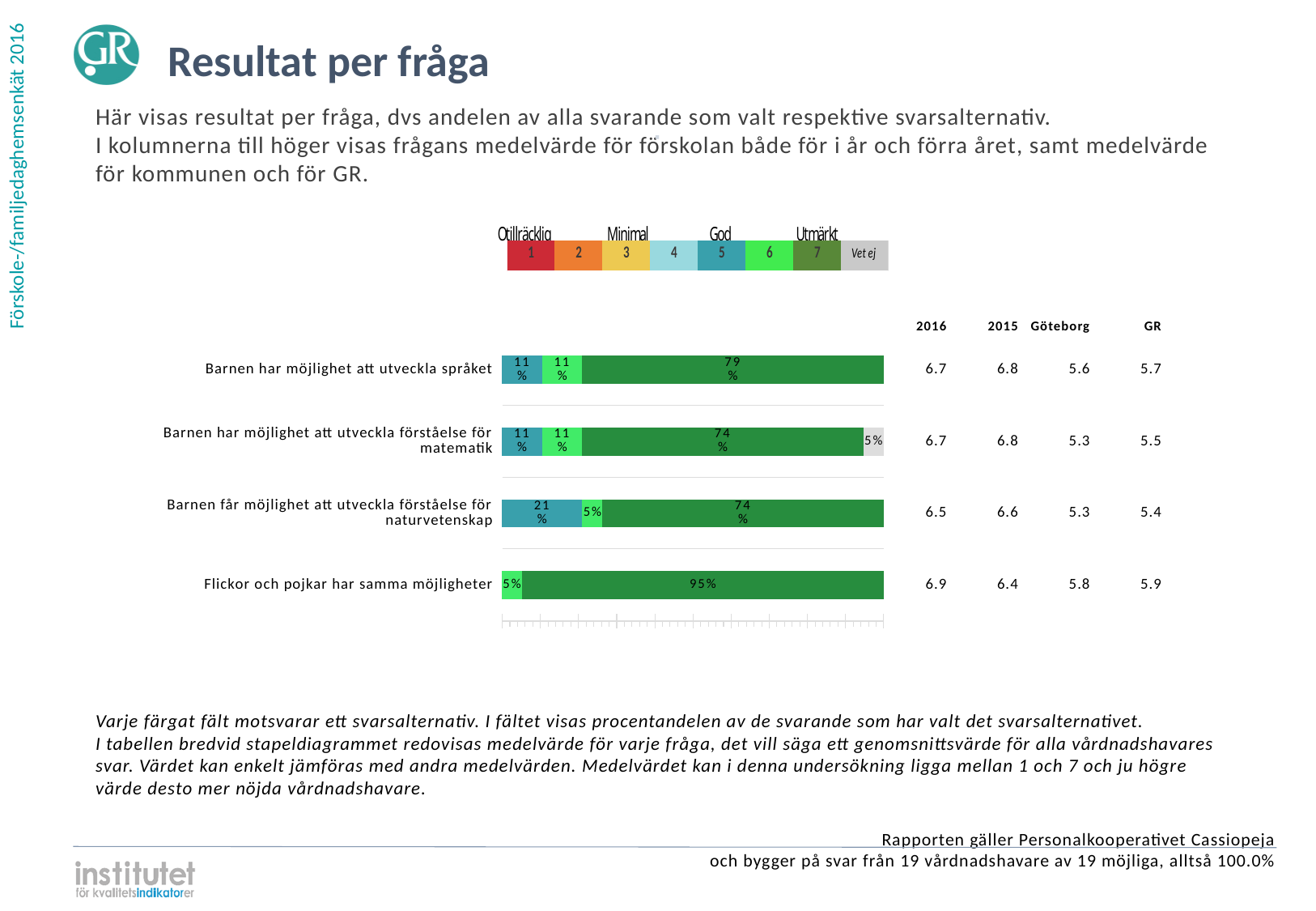
Which is larger: the answer 5 share for 'Barnen får möjlighet att utveckla förståelse för naturvetenskap' or for 'Barnen har möjlighet att utveckla språket'? Barnen får möjlighet att utveckla förståelse för naturvetenskap What percentage of respondents answered 'Vet ej' for 'Barnen har möjlighet att utveckla förståelse för matematik'? 5% What percentage of respondents chose answer 7 (dark green) for 'Flickor och pojkar har samma möjligheter'? 95% What is the 2016 mean value for 'Flickor och pojkar har samma möjligheter'? 6.9 What percentage of respondents chose answer 5 (teal) for 'Barnen får möjlighet att utveckla förståelse för naturvetenskap'? 21% What is the difference between the answer 7 share for 'Flickor och pojkar har samma möjligheter' (95%) and for 'Barnen har möjlighet att utveckla språket' (79%)? 16% What kind of chart is shown on the slide? Stacked bar chart What is the combined share of answers 5 and 6 for 'Barnen har möjlighet att utveckla språket'? 22% Which question has the largest share of respondents choosing answer 7 (dark green)? Flickor och pojkar har samma möjligheter How many answer alternatives does the legend above the chart list, including 'Vet ej'? 8 How many questions (bars) are shown in the chart? 4 What percentage of respondents chose answer 7 (dark green) for 'Barnen har möjlighet att utveckla språket'? 79%